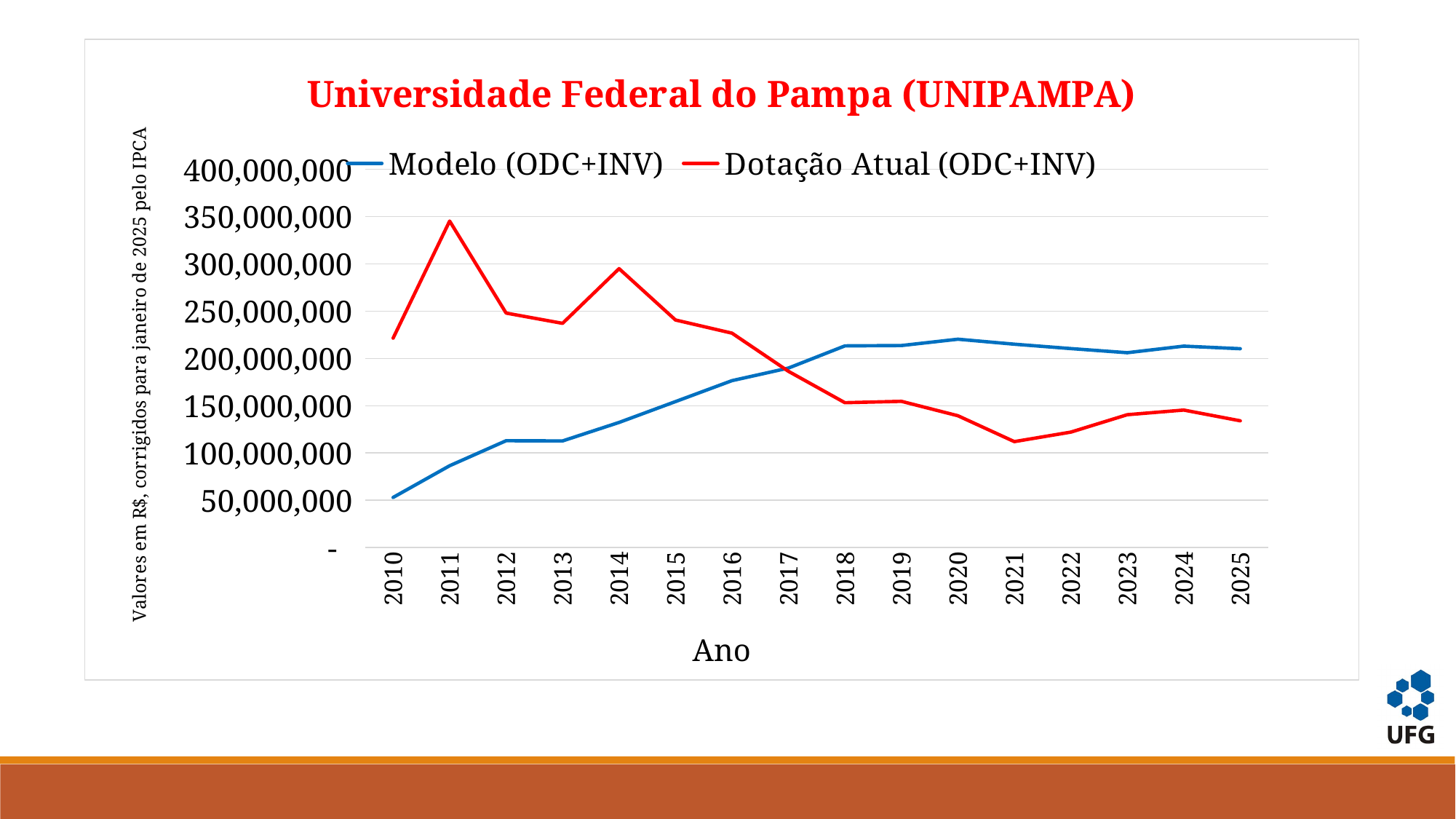
How many years are plotted along the x axis? 16 In which year is the Modelo (ODC+INV) series at its lowest value? 2010 In which year does the Dotação Atual (ODC+INV) series reach its highest value? 2011 What kind of chart is shown on the slide? line chart In 2012, which series has the higher value, Modelo (ODC+INV) or Dotação Atual (ODC+INV)? Dotação Atual (ODC+INV) How many series does the legend list? 2 In which year is the Dotação Atual (ODC+INV) series at its lowest value? 2021 Is the Modelo (ODC+INV) value for 2010 greater or less than 100,000,000? less Is the Dotação Atual (ODC+INV) value for 2011 greater or less than 300,000,000? greater What is the title of the chart? Universidade Federal do Pampa (UNIPAMPA) Does the Modelo (ODC+INV) series rise or fall from 2010 to 2018? rise In 2020, which series has the higher value, Modelo (ODC+INV) or Dotação Atual (ODC+INV)? Modelo (ODC+INV)